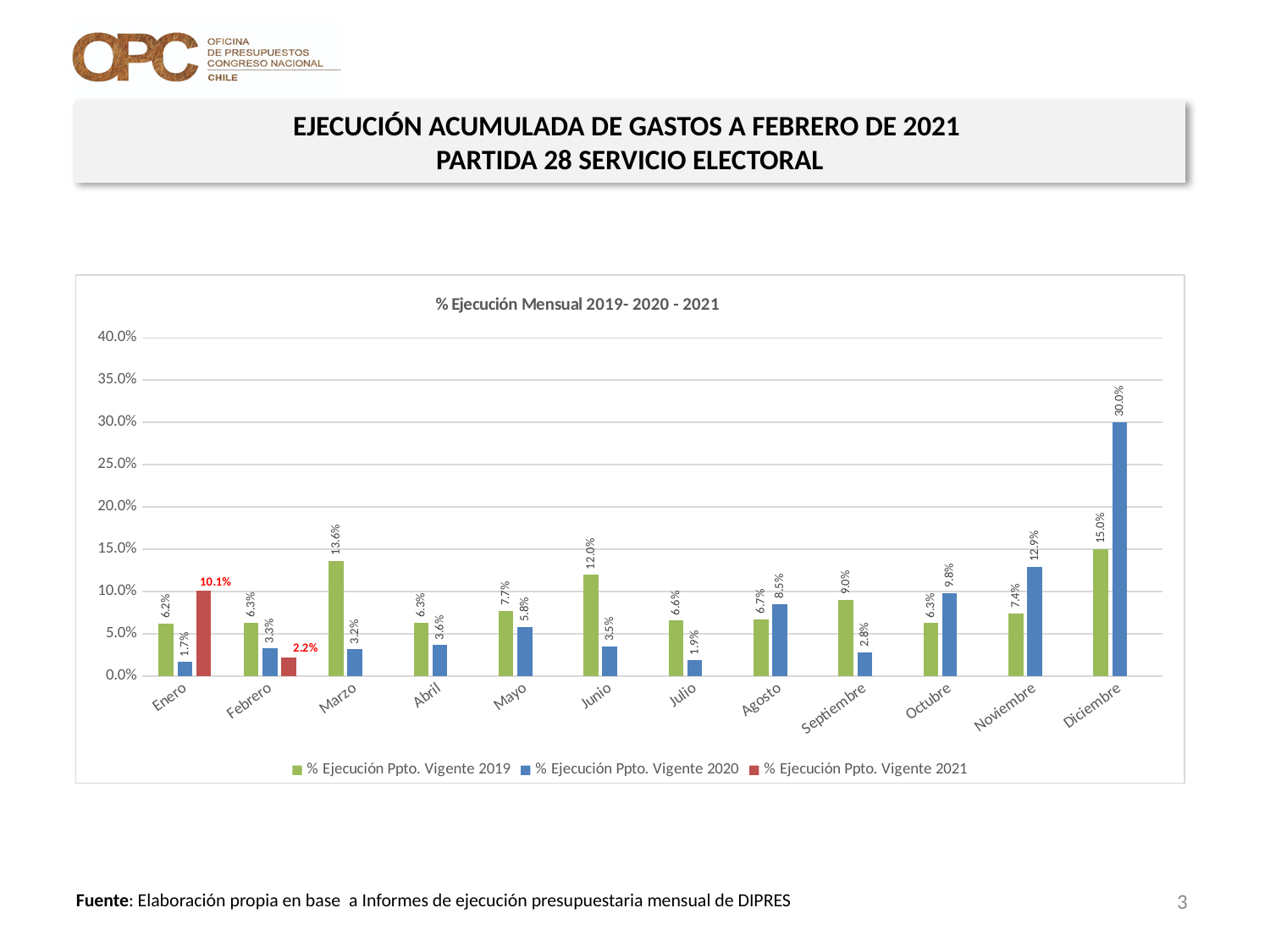
What is the value for % Ejecución Ppto. Vigente 2021 in Enero? 10.1% In Agosto, which is larger: the 2019 value or the 2020 value? 2020 Which month has the lowest value for % Ejecución Ppto. Vigente 2020? Enero Is the value for % Ejecución Ppto. Vigente 2020 in Noviembre greater or less than 10.0%? greater What is the difference between the 2020 and 2019 values in Diciembre? 15.0% What is the title of the chart? % Ejecución Mensual 2019- 2020 - 2021 How many series does the legend list? 3 How many months are shown on the x axis? 12 Which month has the highest value for % Ejecución Ppto. Vigente 2019? Diciembre What is the value for % Ejecución Ppto. Vigente 2020 in Diciembre? 30.0% What is the value for % Ejecución Ppto. Vigente 2019 in Marzo? 13.6% What type of chart is shown on the slide? bar chart